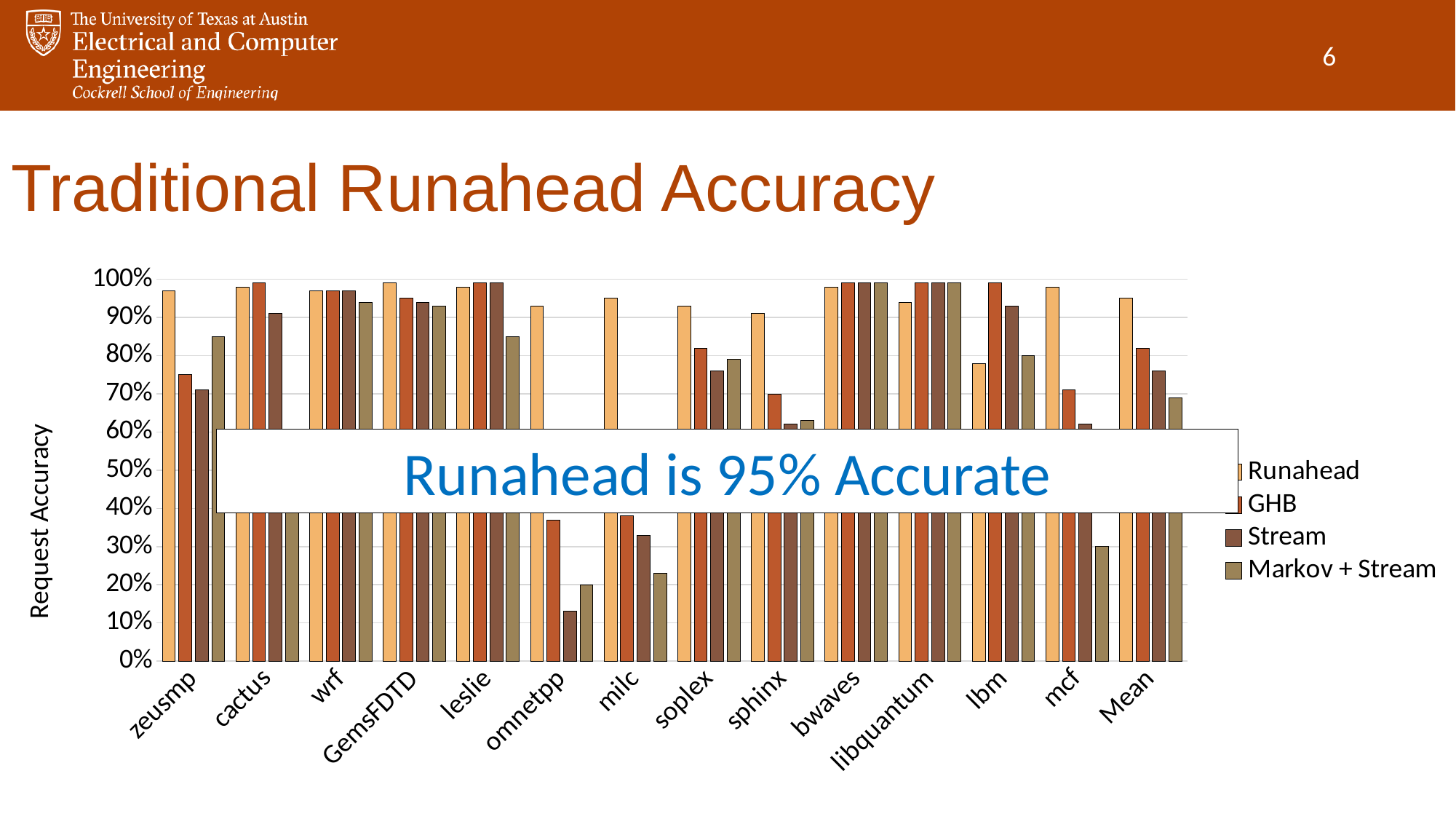
How many series does the legend list? 4 Is the Markov + Stream value for milc greater or less than 30%? less Which series has the lowest value for omnetpp? Stream What kind of chart is shown on the slide? bar chart What is the label on the y axis? Request Accuracy Is the Stream value for Mean greater or less than 70%? greater Which series has the highest value for zeusmp? Runahead Is the Runahead value for zeusmp greater or less than 90%? greater For omnetpp, which is larger: the Runahead value or the GHB value? Runahead How many categories are shown along the x axis? 14 Which category has the lowest Runahead value? lbm